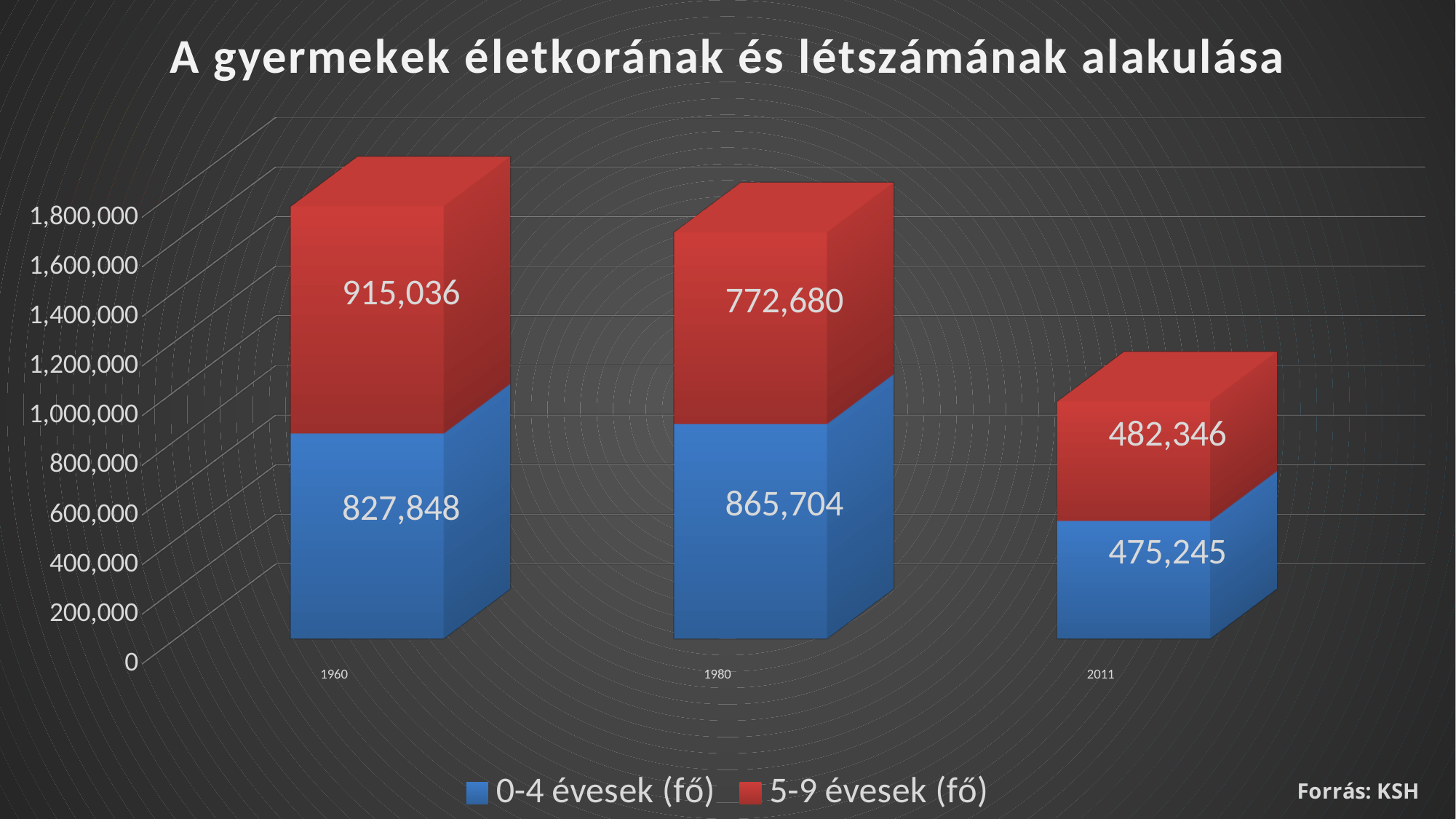
What is the value for 0-4 évesek (fő) in 1960? 827,848 Which is larger in 1980: the 0-4 évesek (fő) value or the 5-9 évesek (fő) value? 0-4 évesek (fő) What is the value for 5-9 évesek (fő) in 2011? 482,346 What is the value for 5-9 évesek (fő) in 1980? 772,680 What is the difference between the 5-9 évesek (fő) and 0-4 évesek (fő) values in 1960? 87,188 In which year is the value for 0-4 évesek (fő) highest? 1980 How many years are shown on the x axis? 3 By how much did the 0-4 évesek (fő) value fall from 1960 to 2011? 352,603 In which year is the value for 5-9 évesek (fő) lowest? 2011 What is the total of the stacked bar for 2011? 957,591 What is the total of the stacked bar for 1960? 1,742,884 How many series does the legend list? 2